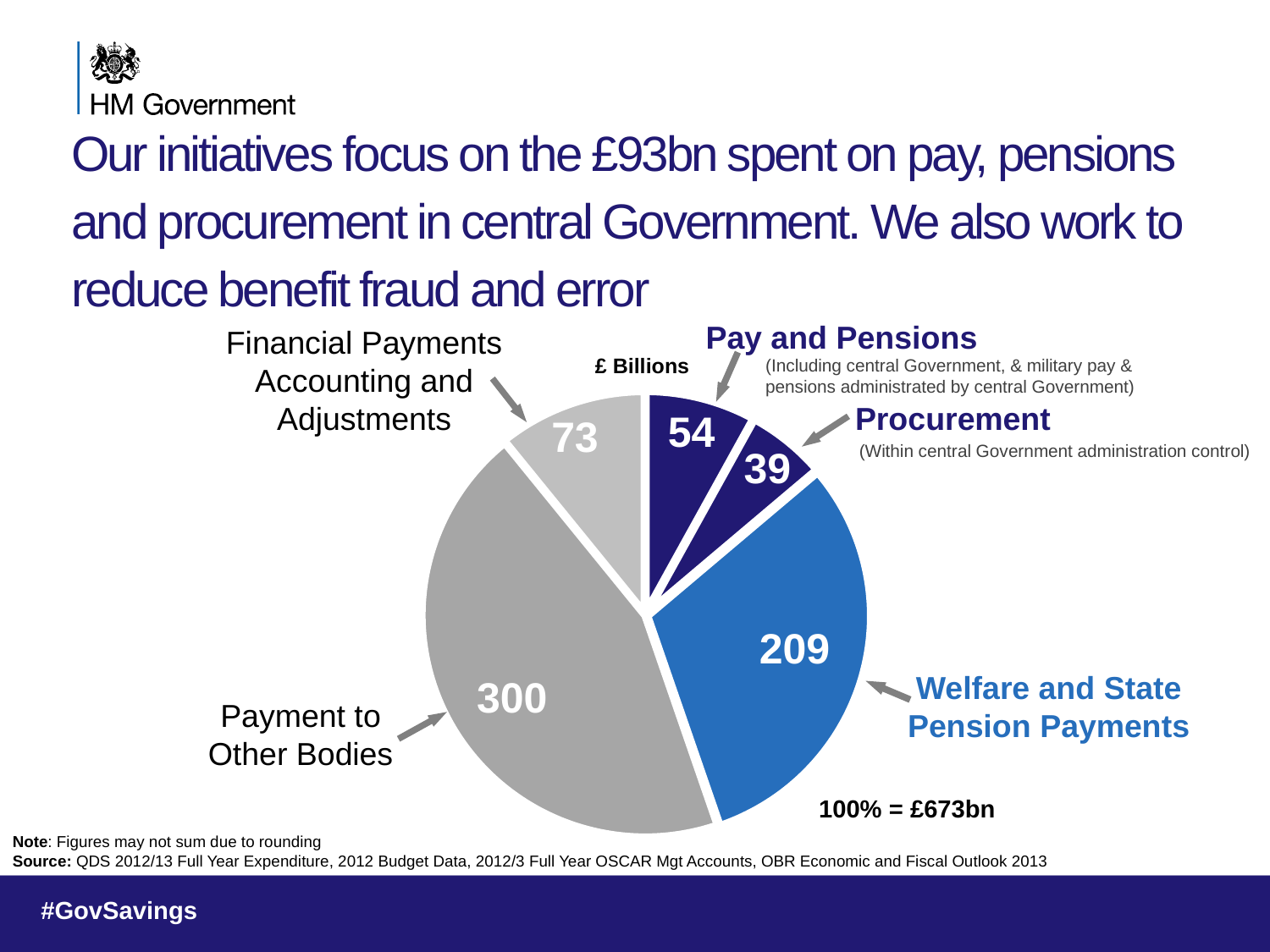
How many slices does the pie chart have? 5 What is the value for Financial Payments Accounting and Adjustments? 73 What is the value for Welfare and State Pension Payments? 209 What is the value for Payment to Other Bodies? 300 Which is larger, Financial Payments Accounting and Adjustments or Pay and Pensions? Financial Payments Accounting and Adjustments What is the value for Procurement? 39 Which category has the largest slice of the pie? Payment to Other Bodies What is the value for Pay and Pensions? 54 Which category has the smallest slice of the pie? Procurement What is the difference between Payment to Other Bodies and Welfare and State Pension Payments? 91 What is the difference between Pay and Pensions and Procurement? 15 What kind of chart is shown on the slide? Pie chart